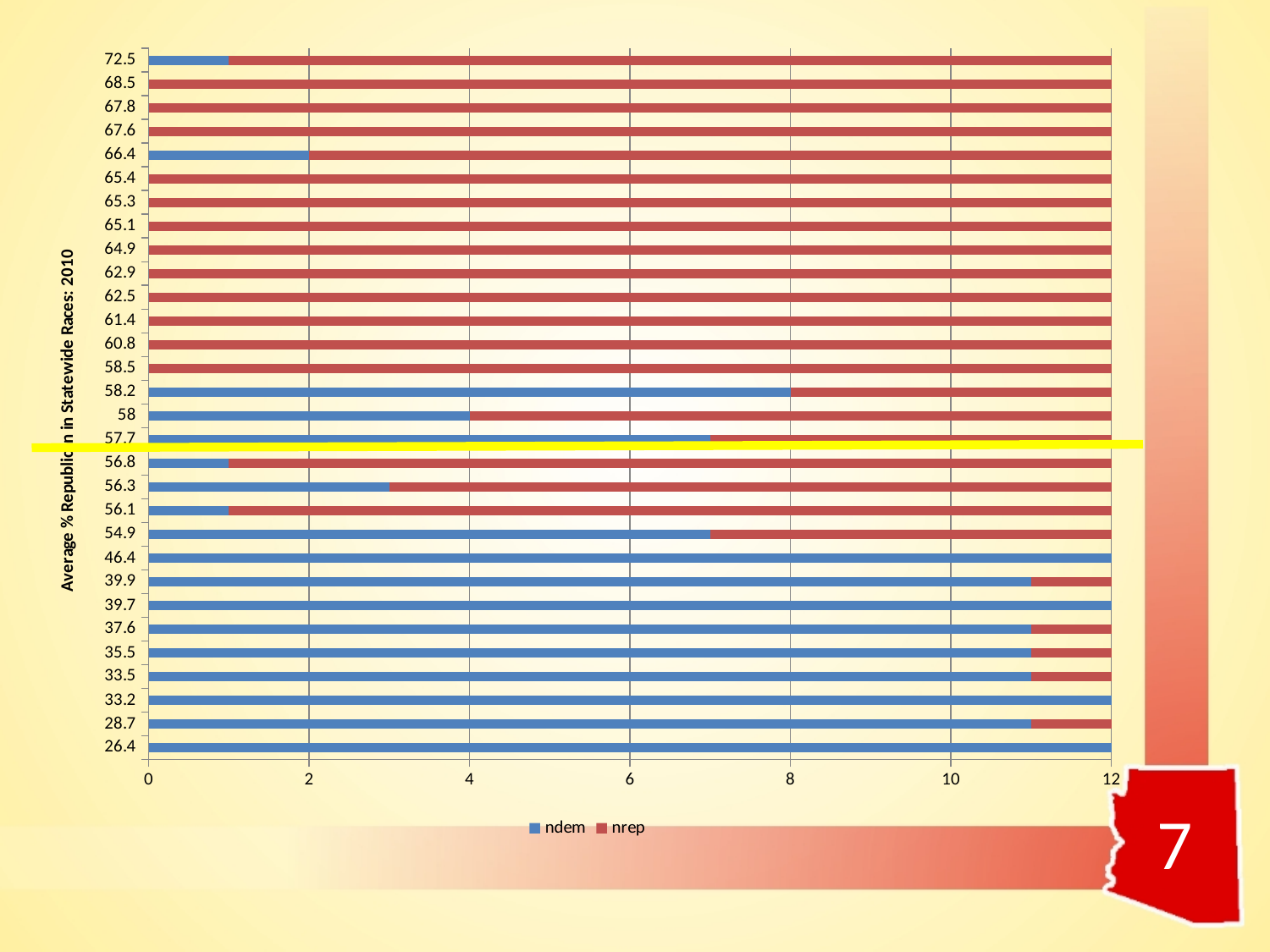
How many categories are plotted on the vertical axis? 30 How many series does the legend list? 2 What is the ndem value for the 66.4 category? 2 Is the ndem value for the 57.7 category greater or less than 6? greater What is the ndem value for the 58 category? 4 What is the ndem value for the 58.2 category? 8 What is the ndem value for the 26.4 category? 12 What is the difference between the ndem values for the 58.2 and 58 categories? 4 What are the two series named in the legend? ndem and nrep Which has the larger ndem value, the 58.2 category or the 58 category? 58.2 What kind of chart is shown on the slide? bar chart Is the ndem value for the 72.5 category greater or less than 2? less